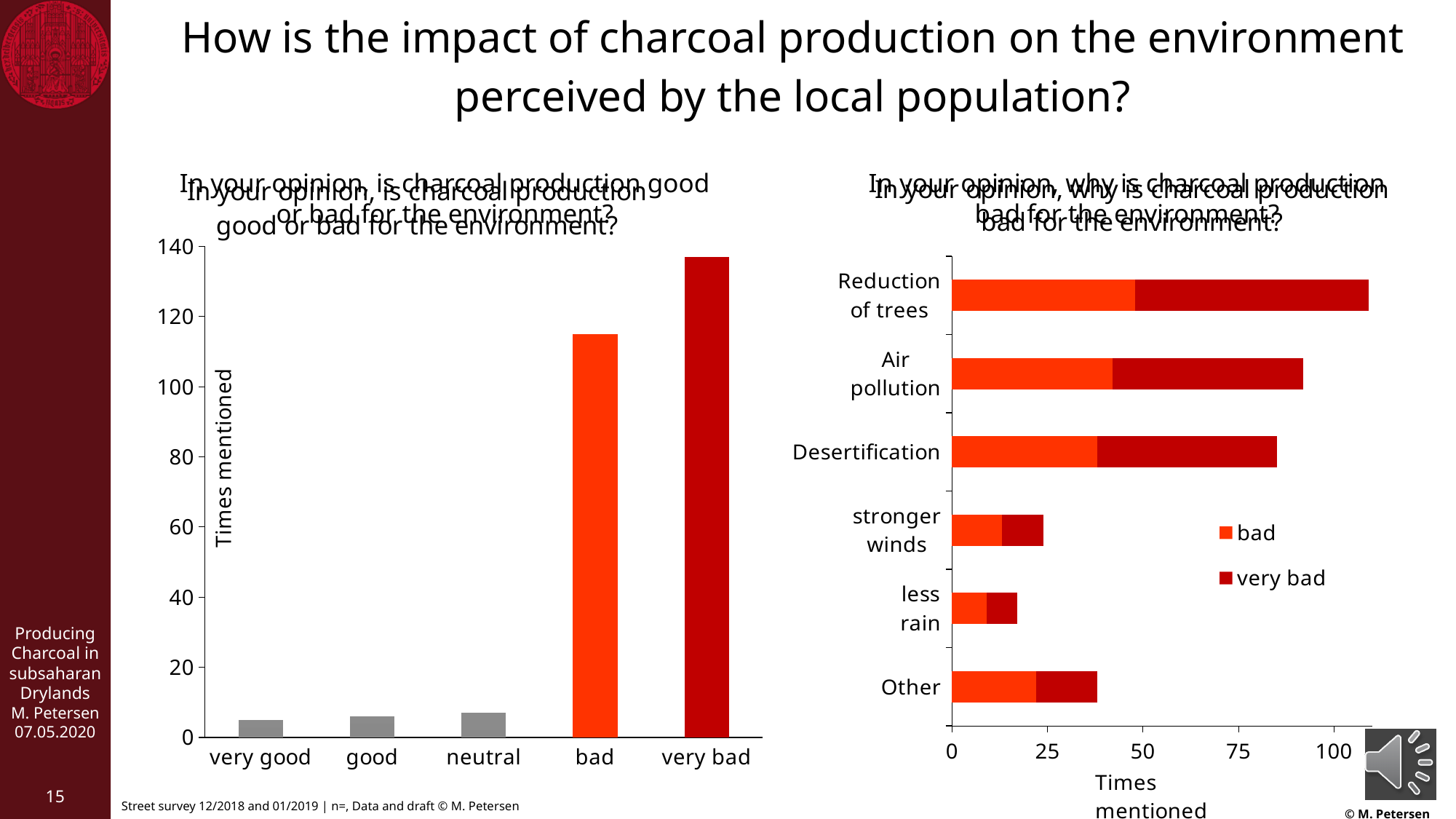
In the left chart, 'In your opinion, is charcoal production good or bad for the environment?', how many categories are shown on the x axis? 5 In the left chart, 'In your opinion, is charcoal production good or bad for the environment?', what is the label of the y axis? Times mentioned In the right chart, 'In your opinion, why is charcoal production bad for the environment?', how many categories are shown? 6 In the left chart, 'In your opinion, is charcoal production good or bad for the environment?', what kind of chart is shown? bar chart In the right chart, 'In your opinion, why is charcoal production bad for the environment?', how many series does the legend list? 2 In the left chart, 'In your opinion, is charcoal production good or bad for the environment?', is the value for 'bad' greater or less than 100? greater In the right chart, 'In your opinion, why is charcoal production bad for the environment?', which is larger, the total bar for 'Other' or the total bar for 'less rain'? Other In the right chart, 'In your opinion, why is charcoal production bad for the environment?', is the total bar for 'Desertification' greater or less than 75? greater In the left chart, 'In your opinion, is charcoal production good or bad for the environment?', is the value for 'neutral' greater or less than 20? less In the right chart, 'In your opinion, why is charcoal production bad for the environment?', which category has the longest total bar? Reduction of trees In the left chart, 'In your opinion, is charcoal production good or bad for the environment?', which is larger, the value for 'bad' or the value for 'very bad'? very bad In the left chart, 'In your opinion, is charcoal production good or bad for the environment?', which category has the highest value? very bad